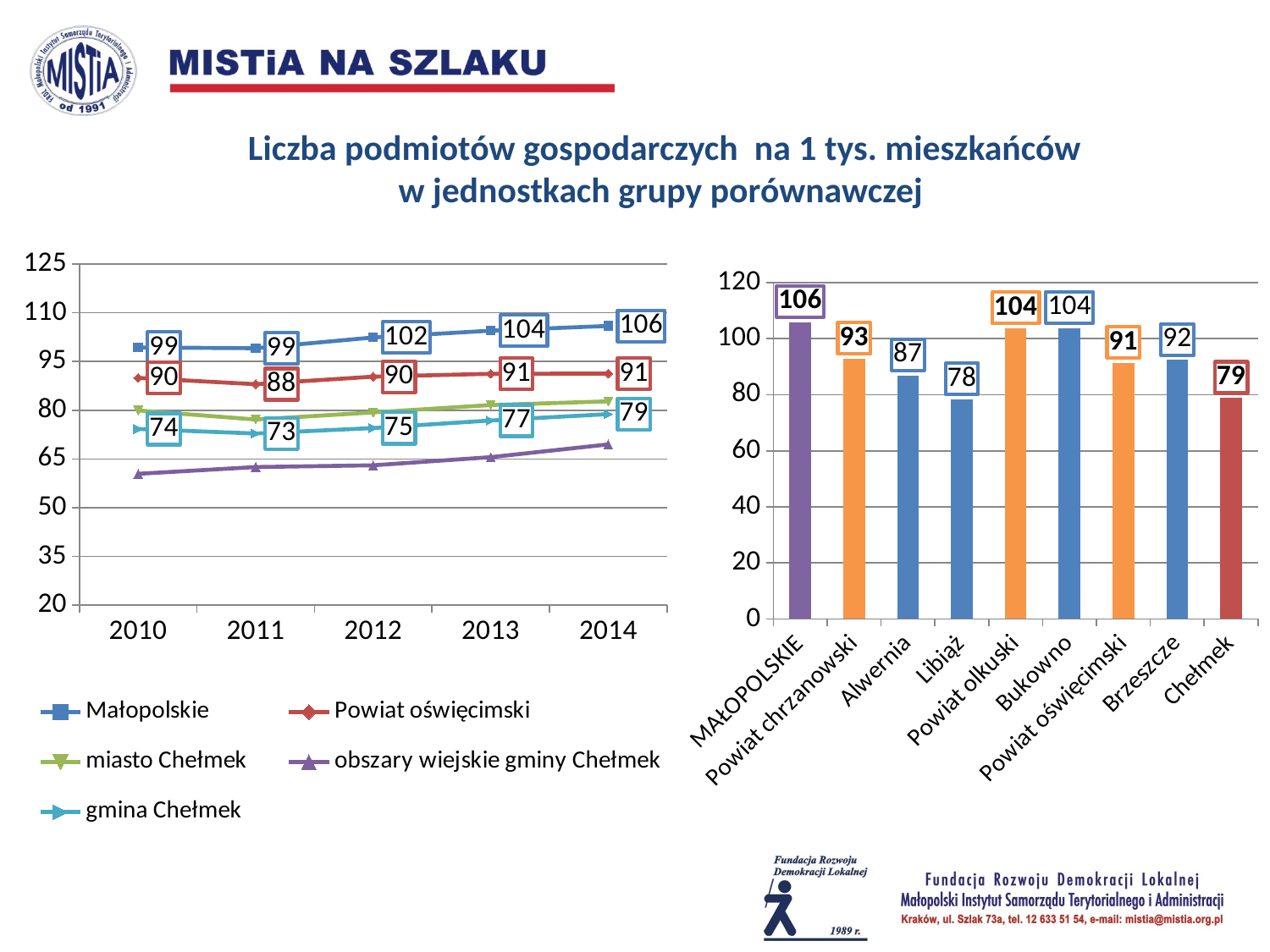
In the left line chart, what is the value for gmina Chełmek in 2011? 73 In the left line chart, what is the difference between Małopolskie and gmina Chełmek in 2014? 27 In the right bar chart, how many categories are shown? 9 In the left line chart, what is the value for Małopolskie in 2014? 106 In the left line chart, how many series does the legend list? 5 In the left line chart, is the value for obszary wiejskie gminy Chełmek in 2010 greater or less than 65? less In the right bar chart, which category has the lowest value? Libiąż In the left line chart, what is the value for Powiat oświęcimski in 2013? 91 In the right bar chart, which is larger, the value for Brzeszcze or the value for Chełmek? Brzeszcze In the right bar chart, what is the value for Libiąż? 78 In the right bar chart, which category has the highest value? MAŁOPOLSKIE In the left line chart, does the value for Małopolskie rise or fall from 2010 to 2014? rise